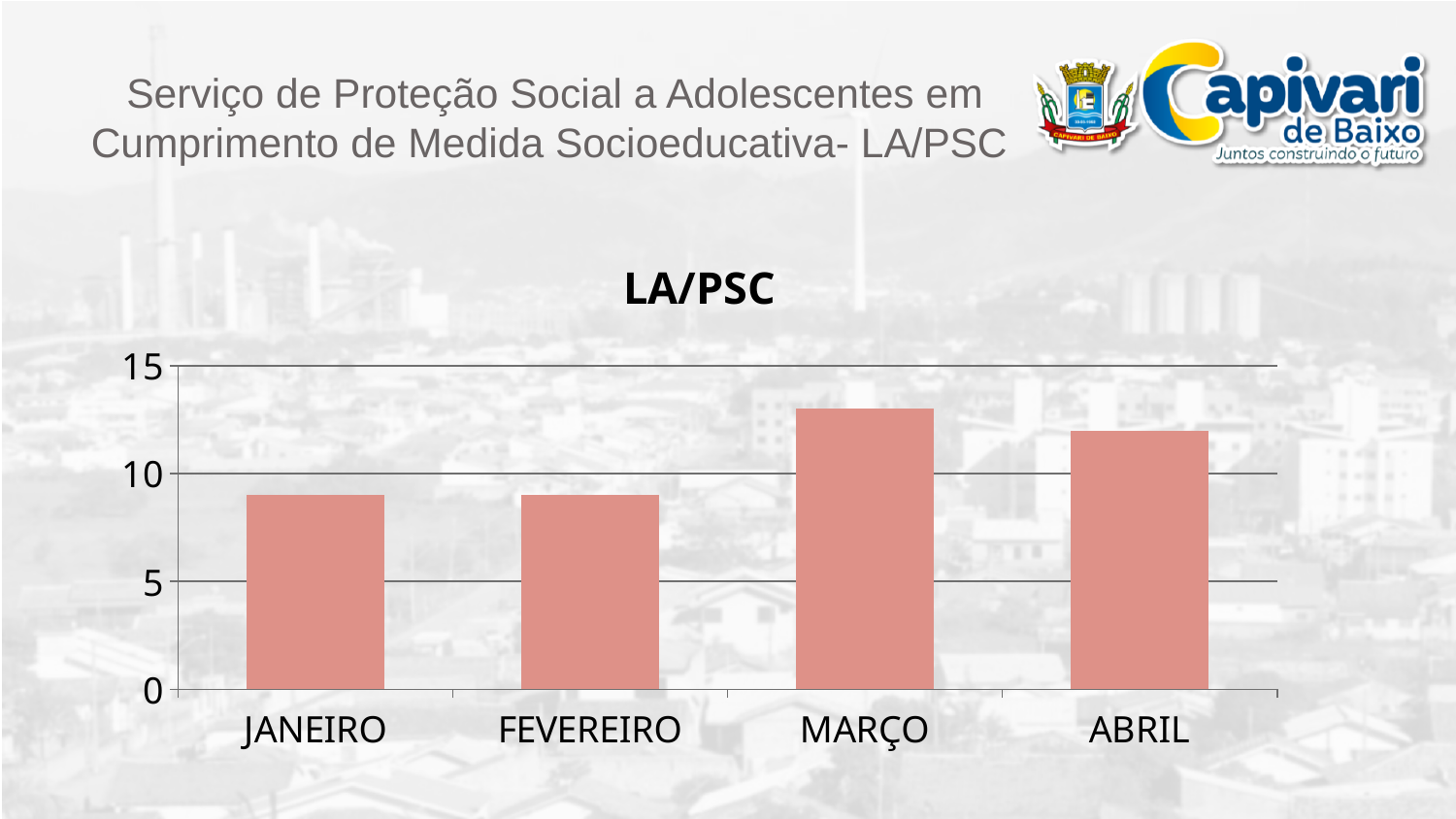
Is the value for ABRIL greater or less than 15? less Is the value for ABRIL greater or less than 10? greater Is the value for JANEIRO greater or less than 10? less What is the title of the chart? LA/PSC Which month has the highest bar in the LA/PSC chart? MARÇO Which is larger, the value for MARÇO or the value for JANEIRO? MARÇO Which is larger, the value for ABRIL or the value for FEVEREIRO? ABRIL What is the highest value shown on the y axis of the chart? 15 How many categories are shown on the x axis of the LA/PSC chart? 4 What kind of chart is shown on the slide? bar chart